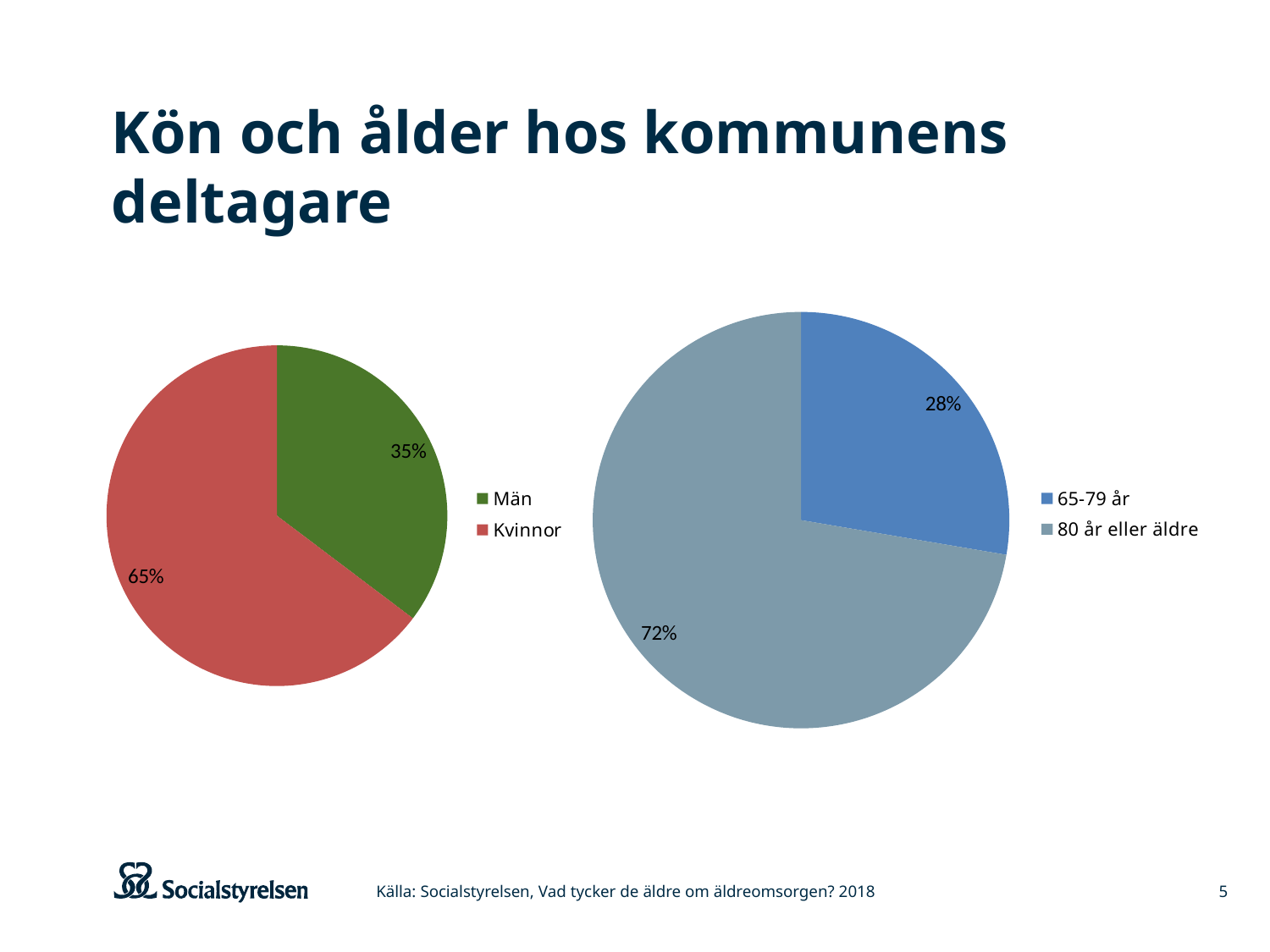
In the left pie chart, which category has the largest slice? Kvinnor In the left pie chart, what is the difference in percentage points between Kvinnor and Män? 30 In the right pie chart, which is larger: 65-79 år or 80 år eller äldre? 80 år eller äldre In the left pie chart, what colour is the Män slice? Green In the right pie chart, what share of participants are 80 år eller äldre? 72% How many categories does the legend of the right pie chart list? 2 In the left pie chart, what share of participants are Män? 35% In the right pie chart, what share of participants are 65-79 år? 28% In the right pie chart, what is the difference in percentage points between 80 år eller äldre and 65-79 år? 44 In the right pie chart, which category has the smallest slice? 65-79 år In the left pie chart, what share of participants are Kvinnor? 65% What kind of chart is the left chart on the slide? Pie chart